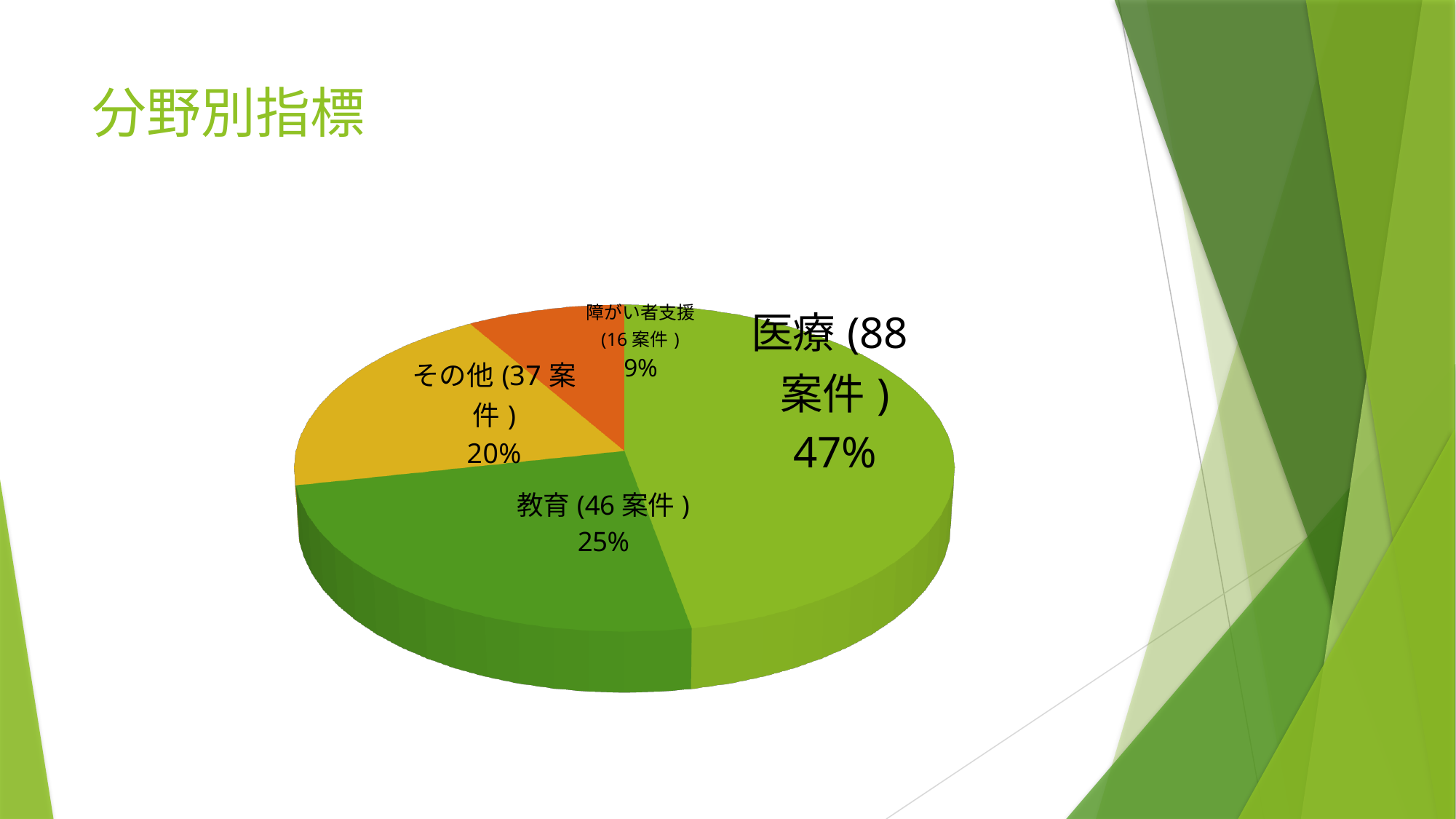
How many 案件 are shown for 障がい者支援? 16 案件 How many 案件 are shown for 医療? 88 案件 How many slices does the pie chart have? 4 What share of the pie does 障がい者支援 represent? 9% What share of the pie does その他 represent? 20% Which category has the smallest slice of the pie? 障がい者支援 What is the title of the slide containing the pie chart? 分野別指標 Which category has the largest slice of the pie? 医療 What share of the pie does 医療 represent? 47% What kind of chart is shown on the slide? Pie chart What is the difference in 案件 between 教育 and その他? 9 案件